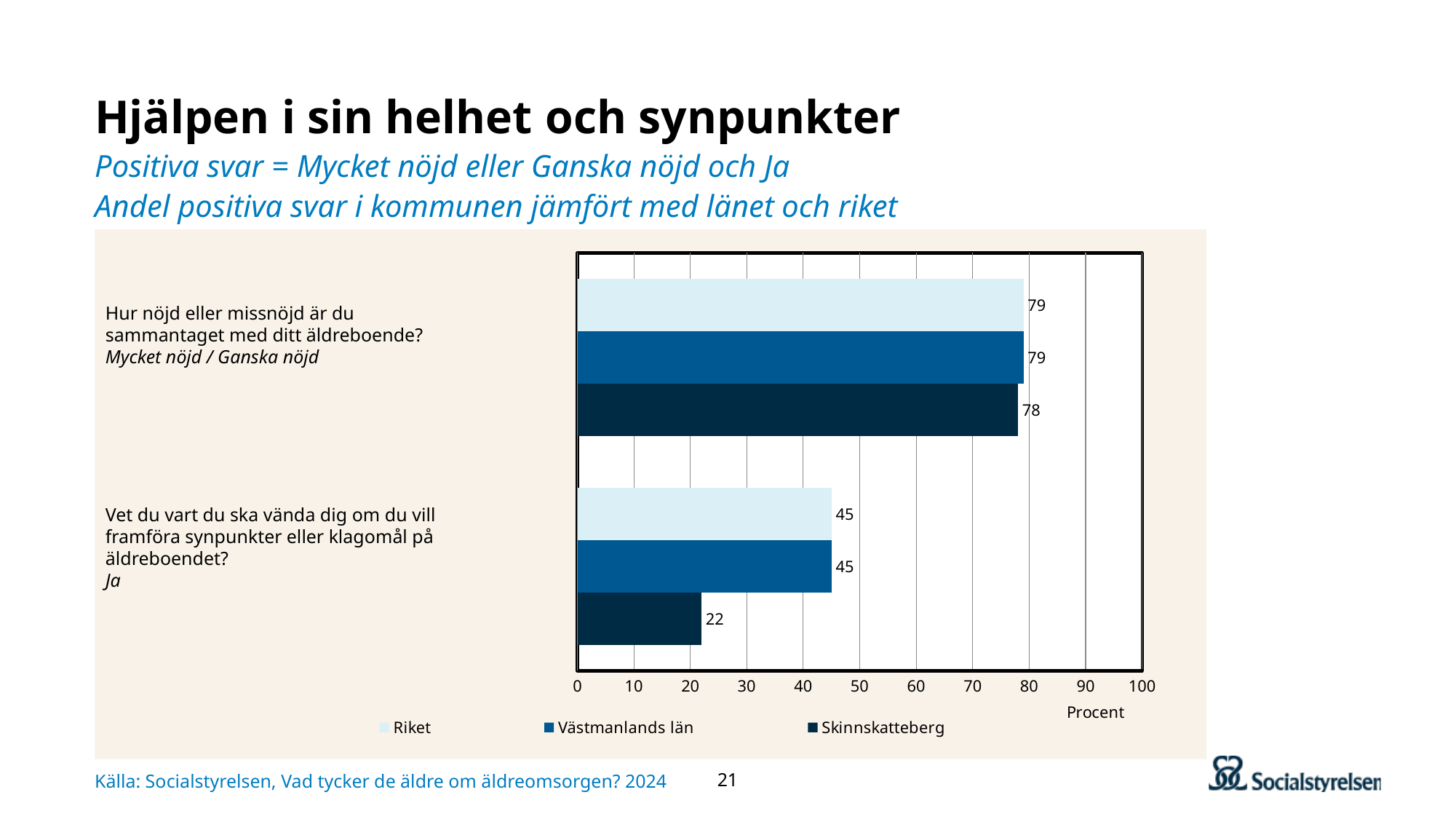
Which series has the lowest value on the question "Vet du vart du ska vända dig om du vill framföra synpunkter eller klagomål på äldreboendet?"? Skinnskatteberg What is the value for Skinnskatteberg on the question "Vet du vart du ska vända dig om du vill framföra synpunkter eller klagomål på äldreboendet?"? 22 What is the difference between Riket and Skinnskatteberg on the question "Vet du vart du ska vända dig om du vill framföra synpunkter eller klagomål på äldreboendet?"? 23 How many series does the legend list? 3 Is the value for Skinnskatteberg on the question "Vet du vart du ska vända dig om du vill framföra synpunkter eller klagomål på äldreboendet?" greater or less than 30? less What unit is labelled on the horizontal axis of the chart? Procent Which is larger for Skinnskatteberg: the value for "Hur nöjd eller missnöjd är du sammantaget med ditt äldreboende?" or the value for "Vet du vart du ska vända dig om du vill framföra synpunkter eller klagomål på äldreboendet?"? Hur nöjd eller missnöjd är du sammantaget med ditt äldreboende? What is the value for Riket on the question "Hur nöjd eller missnöjd är du sammantaget med ditt äldreboende?"? 79 What is the value for Västmanlands län on the question "Vet du vart du ska vända dig om du vill framföra synpunkter eller klagomål på äldreboendet?"? 45 What is the value for Skinnskatteberg on the question "Hur nöjd eller missnöjd är du sammantaget med ditt äldreboende?"? 78 What is the difference between Västmanlands län and Skinnskatteberg on the question "Hur nöjd eller missnöjd är du sammantaget med ditt äldreboende?"? 1 What kind of chart is shown on the slide? bar chart